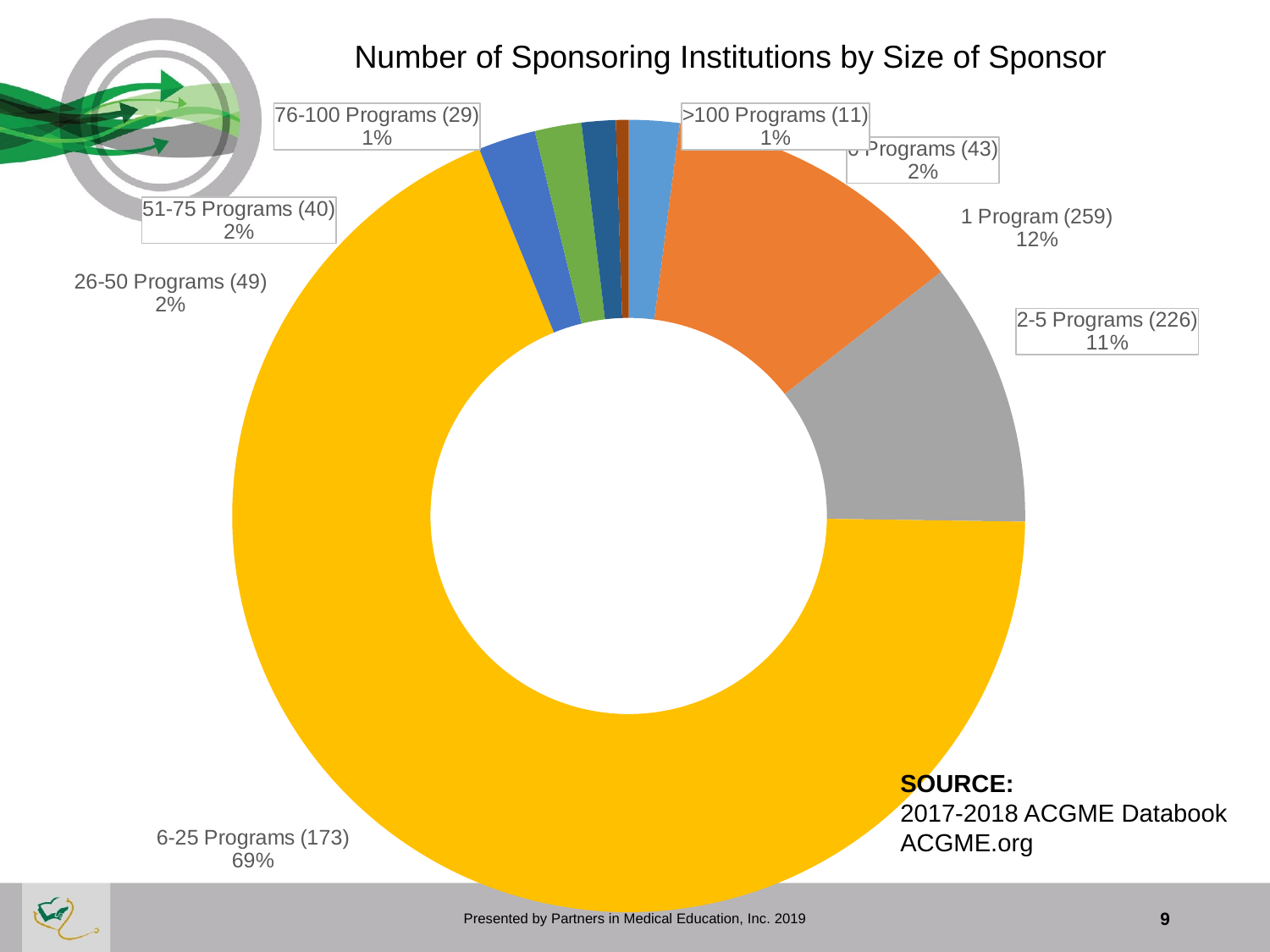
How many slices does the chart have? 8 What is the title of the chart? Number of Sponsoring Institutions by Size of Sponsor How many sponsoring institutions have 1 Program? 259 What percentage share is shown for 6-25 Programs? 69% What kind of chart is shown on the slide? Doughnut (pie) chart Which category has the smallest slice of the chart? >100 Programs What percentage share is shown for 1 Program? 12% How many sponsoring institutions have >100 Programs? 11 How many sponsoring institutions have 2-5 Programs? 226 What is the difference between the number of institutions with 1 Program and those with 2-5 Programs? 33 Which category has the largest slice of the chart? 6-25 Programs Which has more sponsoring institutions: 26-50 Programs or 51-75 Programs? 26-50 Programs